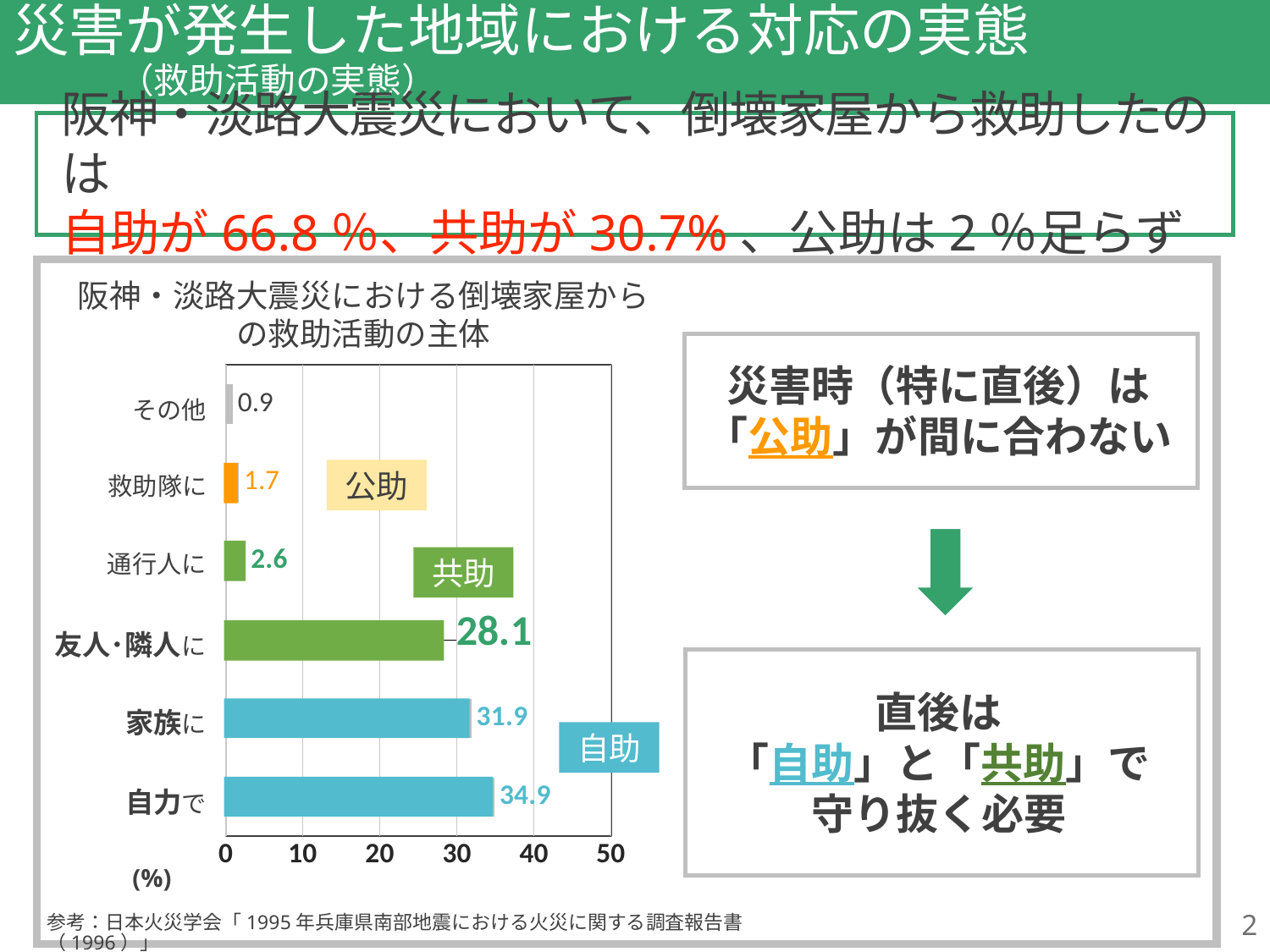
What is the value for 家族に in the chart? 31.9 What is the value for 自力で in the chart? 34.9 What is the title of the chart? 阪神・淡路大震災における倒壊家屋からの救助活動の主体 What is the value for 友人･隣人に in the chart? 28.1 What kind of chart is shown on the slide? bar chart Is the value for 友人･隣人に greater or less than 30? less What is the value for 救助隊に in the chart? 1.7 What is the difference between the values for 自力で and 家族に? 3.0 How many categories are shown in the chart? 6 Which category has the highest value in the chart? 自力で Which category has the lowest value in the chart? その他 Which is larger, the value for 通行人に or the value for 救助隊に? 通行人に